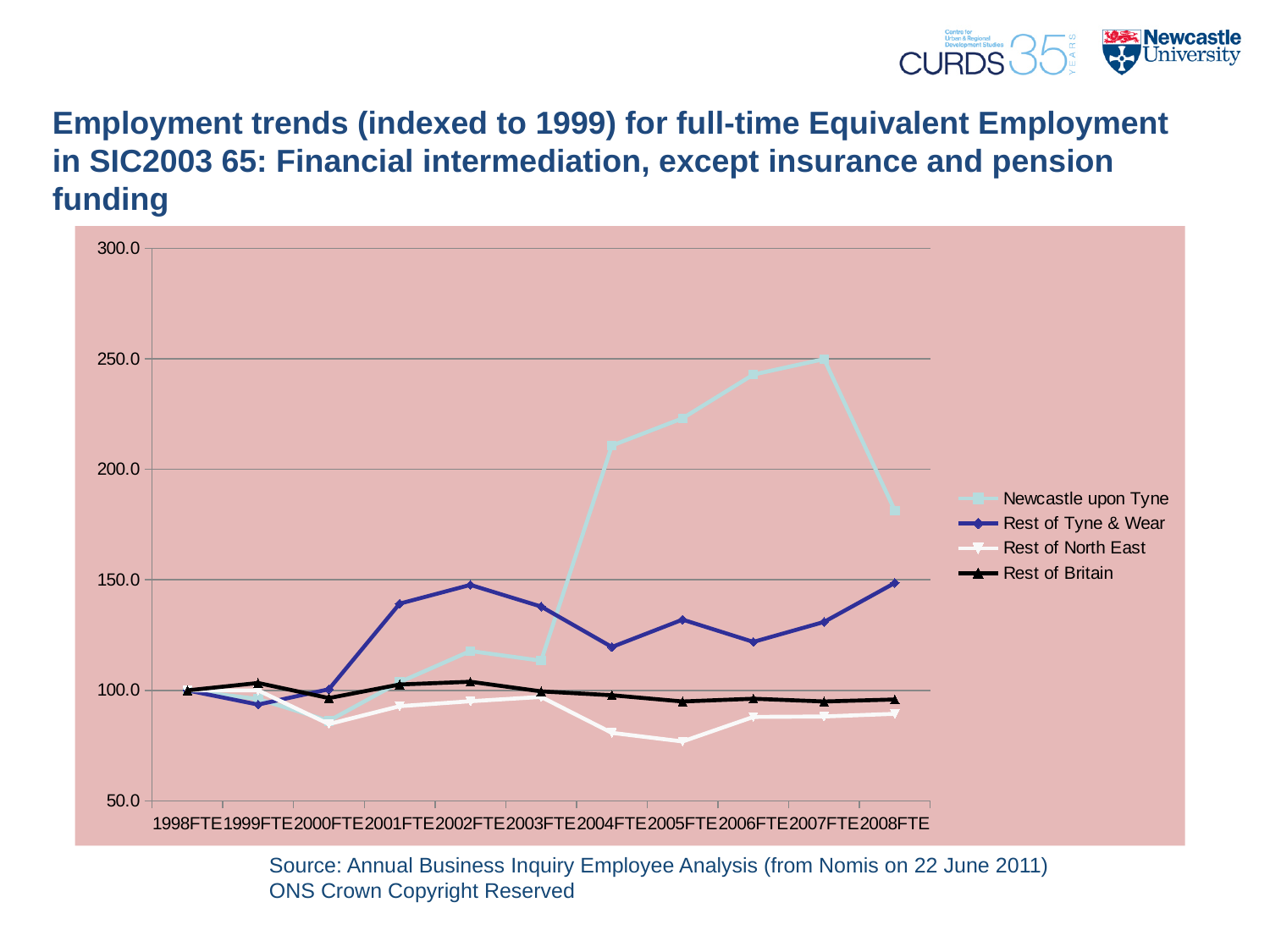
Is the value for Rest of North East in 2005FTE greater or less than 100? less Is the value for Newcastle upon Tyne in 2008FTE greater or less than 200? less Does the Newcastle upon Tyne line rise or fall from 2007FTE to 2008FTE? Fall Is the value for Newcastle upon Tyne in 2006FTE greater or less than 200? greater How many series does the legend list? 4 Which series is drawn with a black line and triangle markers? Rest of Britain In 2002FTE, which is larger: Newcastle upon Tyne or Rest of Tyne & Wear? Rest of Tyne & Wear How many years (points) are shown along the x axis? 11 Which series has the highest value in 2007FTE? Newcastle upon Tyne Which series has the lowest value in 2005FTE? Rest of North East What kind of chart is shown on the slide? Line chart